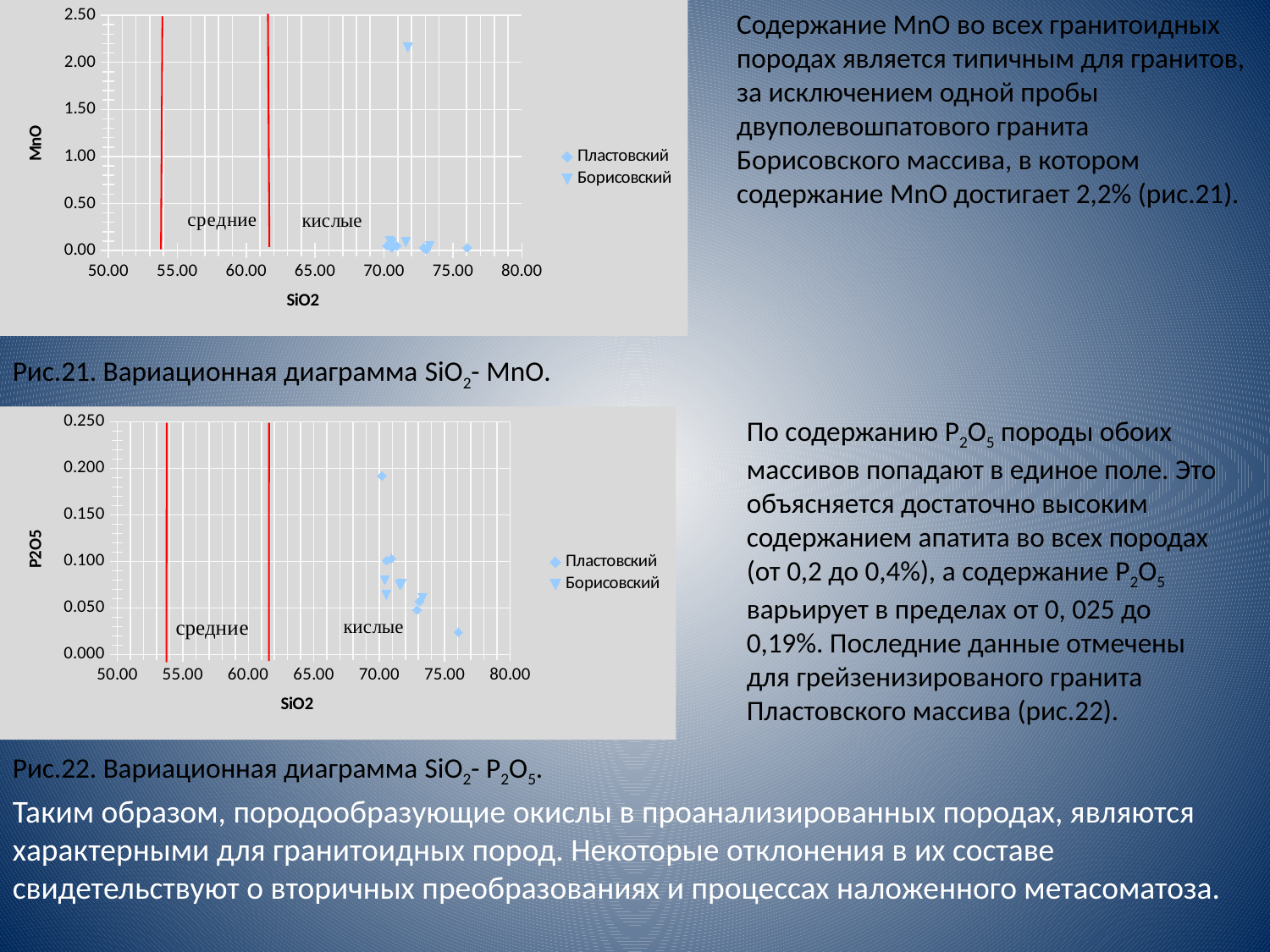
How many series does the legend of the top chart (Рис.21) list? 2 What kind of chart is the bottom chart (Рис.22)? scatter chart In the bottom chart (Рис.22), which series has the highest P2O5 point? Пластовский What kind of chart is the top chart (Рис.21)? scatter chart What are the two series named in the legend of the bottom chart (Рис.22)? Пластовский, Борисовский What is the label of the vertical axis of the bottom chart (Рис.22)? P2O5 What is the maximum value shown on the horizontal axis of the bottom chart (Рис.22)? 80.00 What is the maximum value shown on the vertical axis of the top chart (Рис.21)? 2.50 In the bottom chart (Рис.22), is the P2O5 value of the highest point greater or less than 0.150? greater In the top chart (Рис.21), is the MnO value of the highest point greater or less than 2.00? greater In the top chart (Рис.21), which series has the highest MnO point? Борисовский In the top chart (Рис.21), are all the Пластовский points at SiO2 values greater or less than 65.00? greater